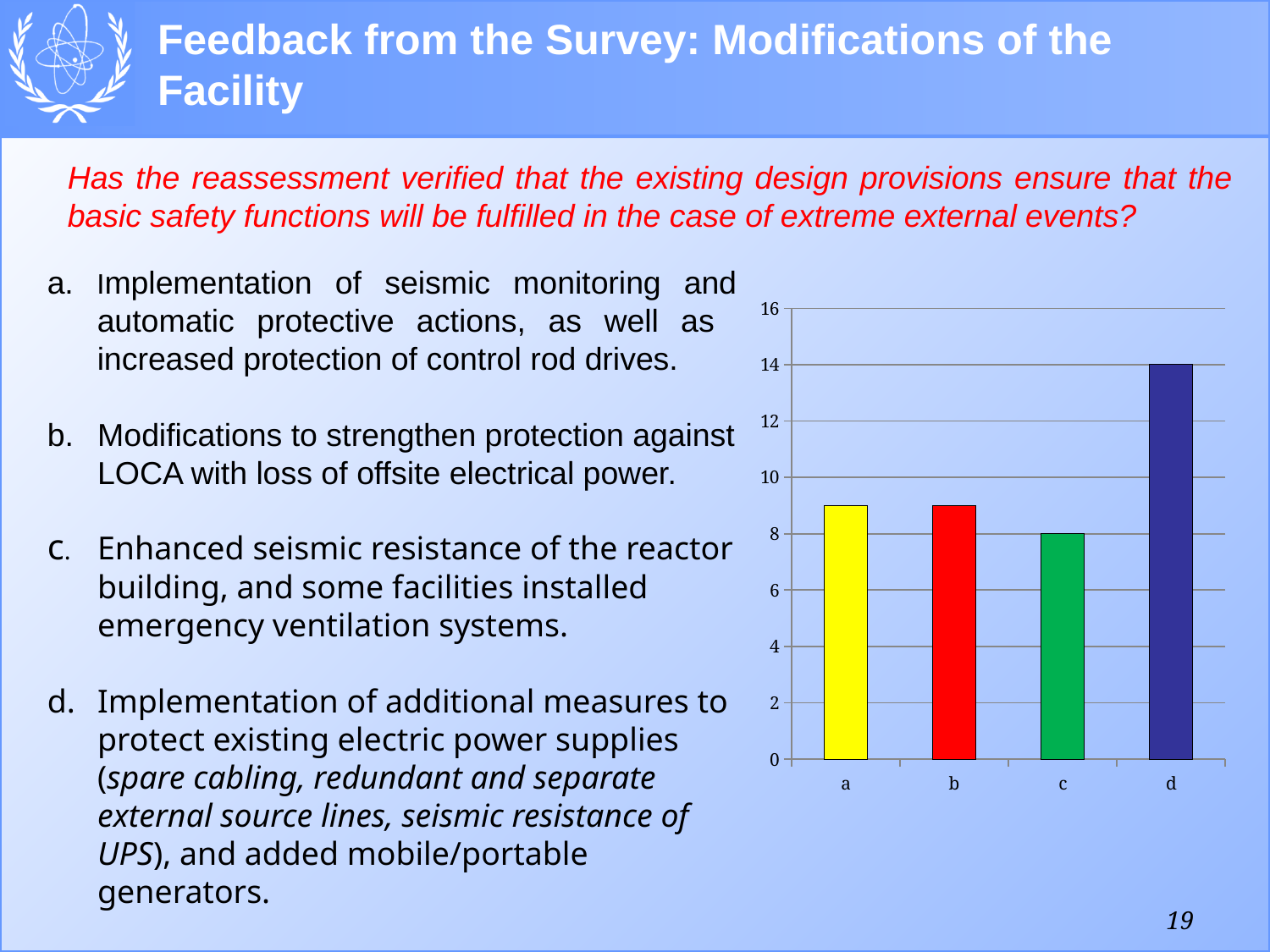
Which category has the highest value? d Is the value for d greater or less than 12? greater What is the value for category d? 14 What is the difference between the values for d and c? 6 Is the value for a greater or less than 8? greater What colour is the bar for category a? yellow Which is larger, the value for d or the value for a? d Is the value for b greater or less than 10? less What is the value for category c? 8 What kind of chart is shown on the slide? bar chart Which category has the lowest value? c How many categories are shown on the x axis? 4